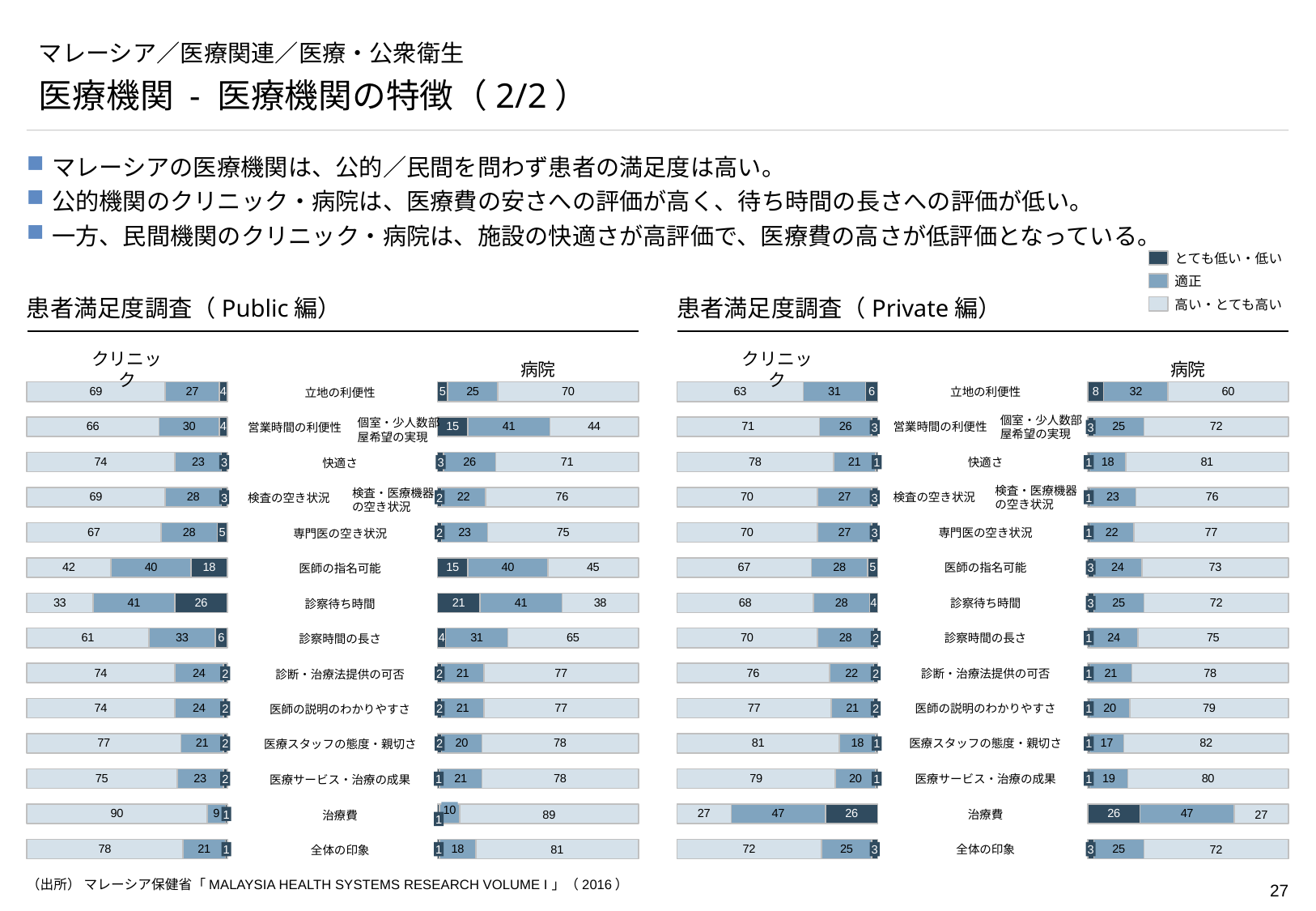
In the 患者満足度調査（Private 編） クリニック chart, which category has the highest とても低い・低い value? 治療費 How many categories are shown in the 患者満足度調査（Private 編） 病院 chart? 14 What type of chart is used for the 患者満足度調査（Public 編） クリニック data? Stacked bar chart How many series does the legend list for the satisfaction charts? 3 In the 患者満足度調査（Public 編） クリニック chart, what is the 高い・とても高い value for 治療費? 90 In the 患者満足度調査（Public 編） 病院 chart, what is the とても低い・低い value for 診察待ち時間? 21 For 医師の指名可能, which has the larger 高い・とても高い value: the Public 編 クリニック chart or the Public 編 病院 chart? 病院 In the 患者満足度調査（Private 編） クリニック chart, what is the 適正 value for 治療費? 47 In the 患者満足度調査（Private 編） 病院 chart, what is the 高い・とても高い value for 快適さ? 81 In the 患者満足度調査（Public 編） クリニック chart, which category has the lowest 高い・とても高い value? 診察待ち時間 In the 患者満足度調査（Public 編） クリニック chart, what is the difference between the 適正 and 高い・とても高い values for 診察待ち時間? 8 In the 患者満足度調査（Public 編） クリニック chart, which category has the highest 高い・とても高い value? 治療費